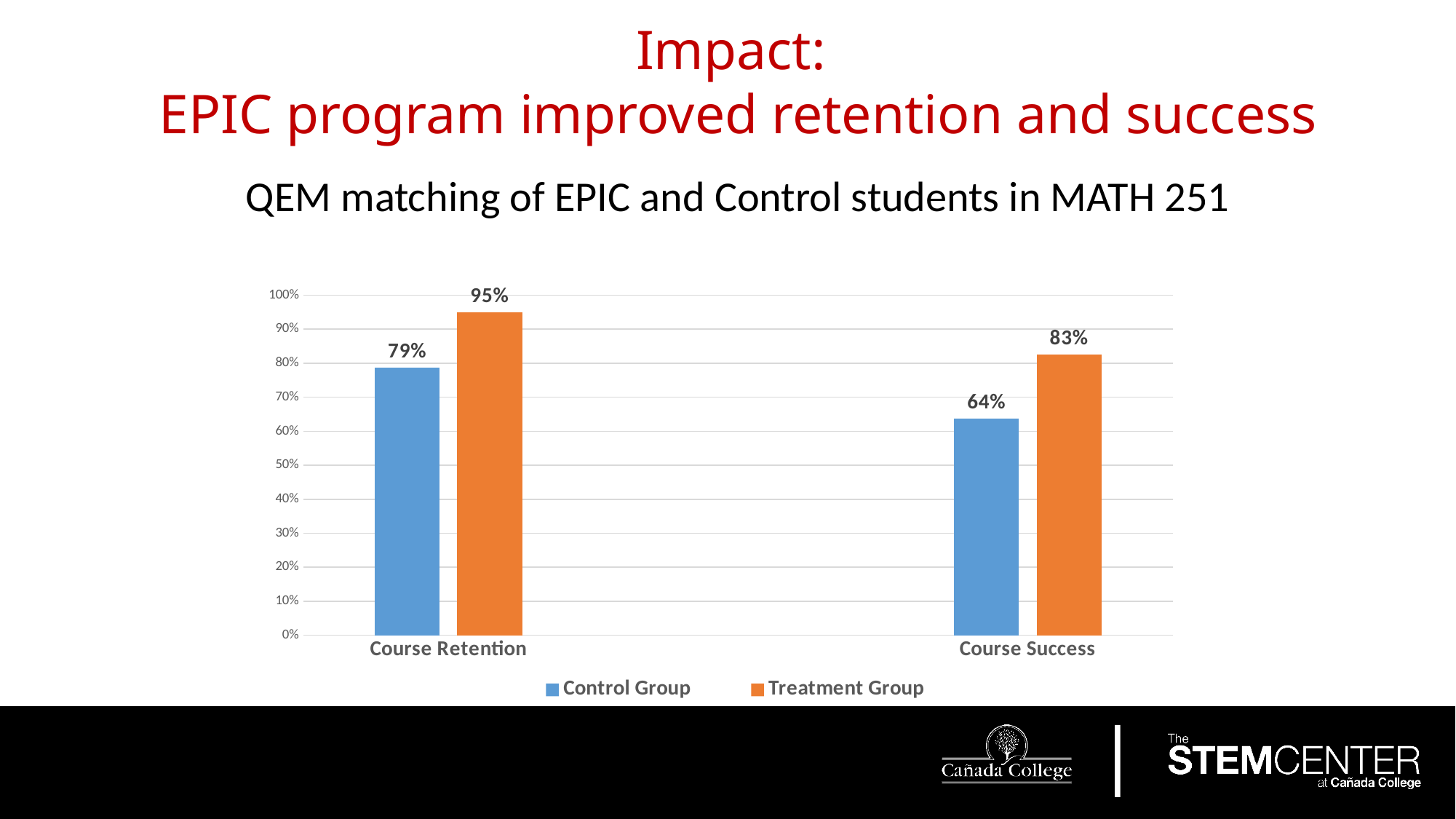
Which colour represents the Treatment Group in the chart? Orange What is the Course Success rate for the Control Group? 64% What is the Course Retention rate for the Control Group? 79% What is the Course Retention rate for the Treatment Group? 95% Which group has the higher Course Success rate, Control Group or Treatment Group? Treatment Group Which bar shows the highest value on the chart? Treatment Group, Course Retention What is the difference between the Treatment Group and Control Group for Course Retention? 16% What kind of chart is shown on the slide? Bar chart How many series does the legend list? 2 What is the Course Success rate for the Treatment Group? 83% What is the difference between the Treatment Group and Control Group for Course Success? 19% Which bar shows the lowest value on the chart? Control Group, Course Success